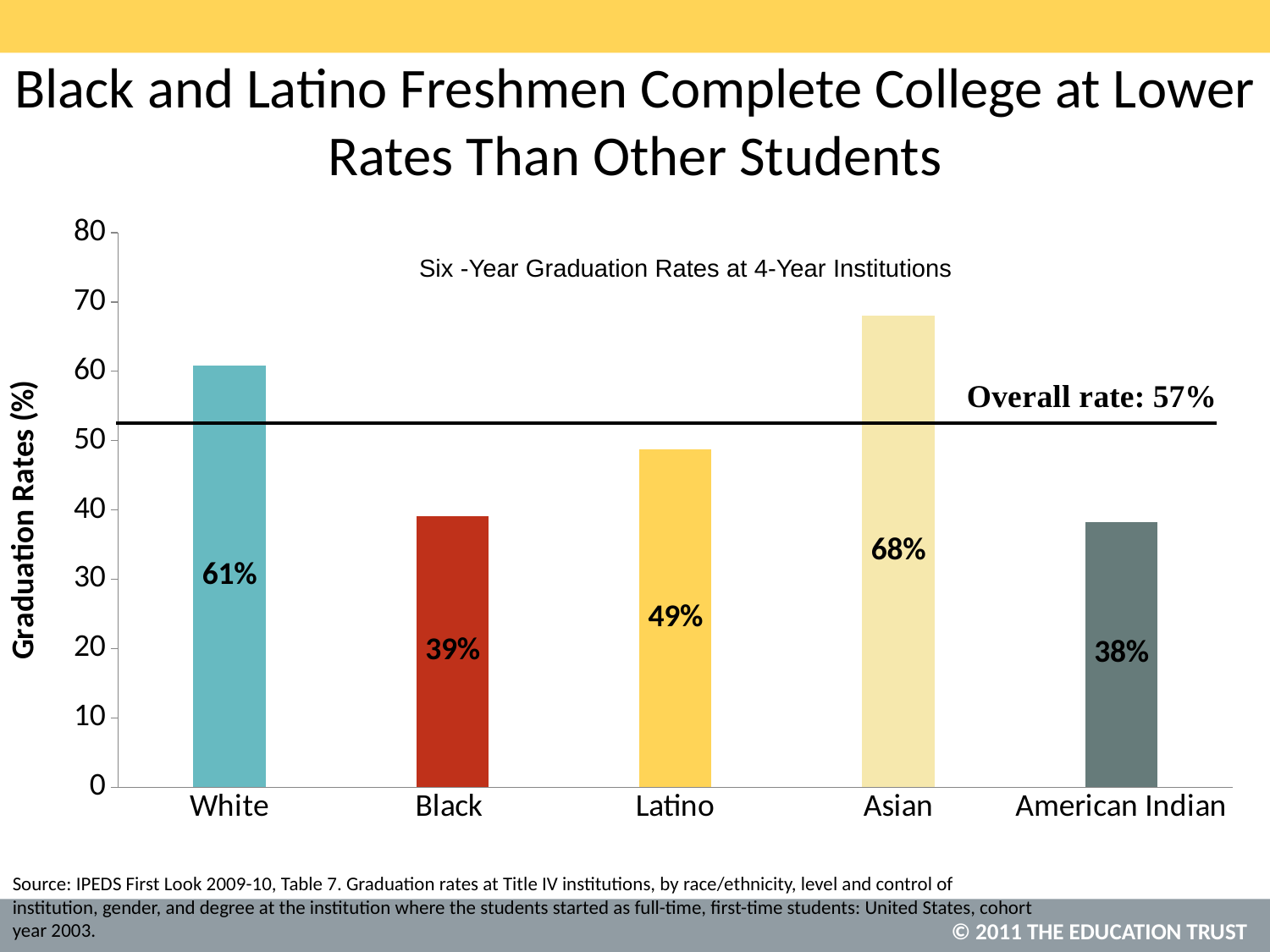
What is the difference between the graduation rates for Asian and Black students? 29% What is the six-year graduation rate for White students? 61% What is the six-year graduation rate for American Indian students? 38% Which group has the lowest six-year graduation rate? American Indian What is the six-year graduation rate for Black students? 39% What is the six-year graduation rate for Latino students? 49% What overall graduation rate is marked by the horizontal line on the chart? 57% Which group has a higher graduation rate, White or Latino? White What type of chart is shown on the slide? Bar chart What is the title printed inside the chart area? Six -Year Graduation Rates at 4-Year Institutions Which group has the highest six-year graduation rate? Asian How many racial/ethnic groups are shown in the chart? 5